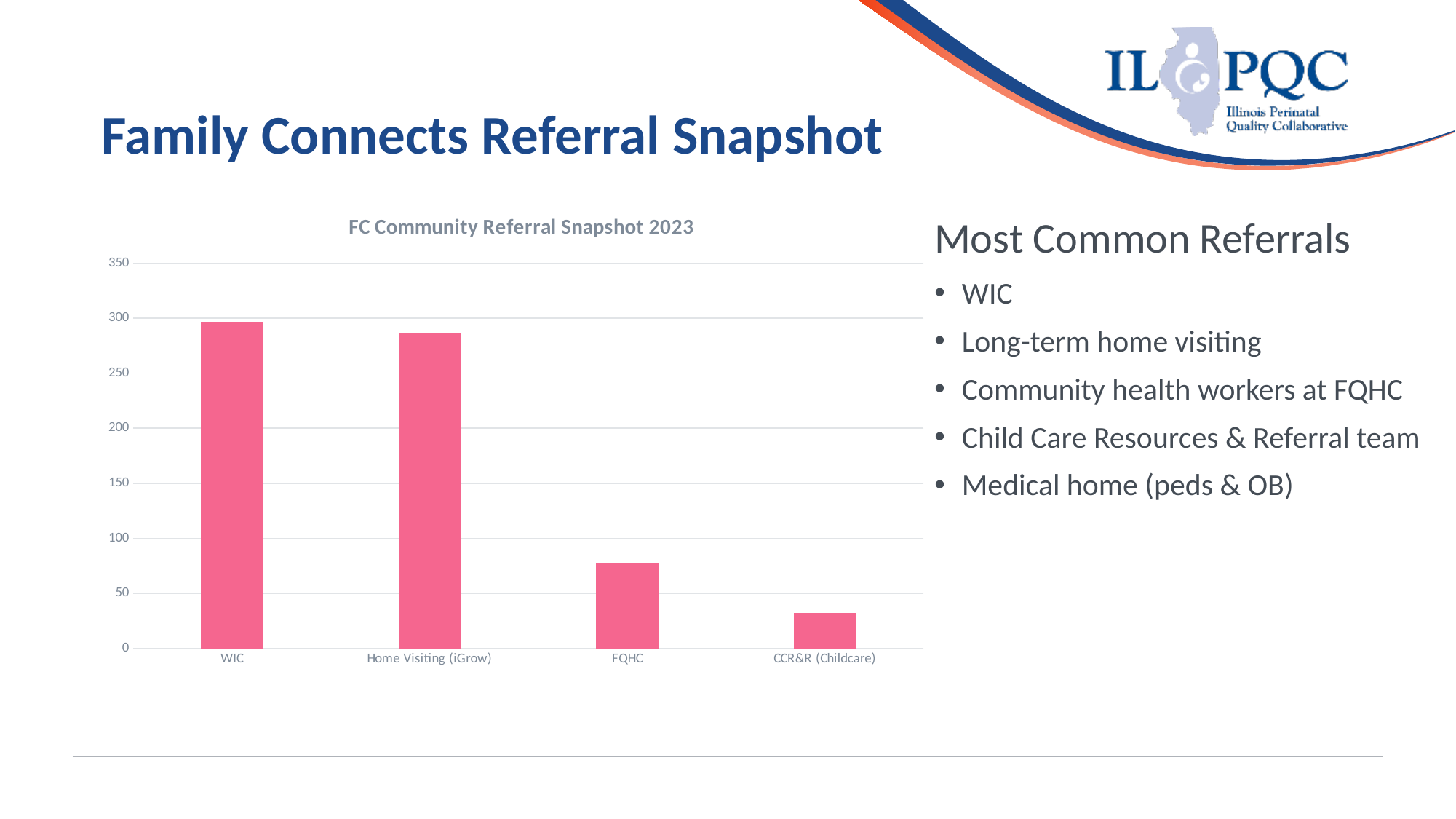
How many categories are shown on the x axis of the chart? 4 Which category has the highest value in the chart? WIC Which category has the lowest value in the chart? CCR&R (Childcare) Is the value for WIC greater or less than 250? greater Is the value for FQHC greater or less than 100? less Is the value for Home Visiting (iGrow) greater or less than 300? less Which is larger, the value for FQHC or the value for CCR&R (Childcare)? FQHC Which is larger, the value for Home Visiting (iGrow) or the value for FQHC? Home Visiting (iGrow) What type of chart is shown on the slide? Bar chart What is the title of the chart? FC Community Referral Snapshot 2023 Do the values rise or fall moving from left to right along the x axis? Fall